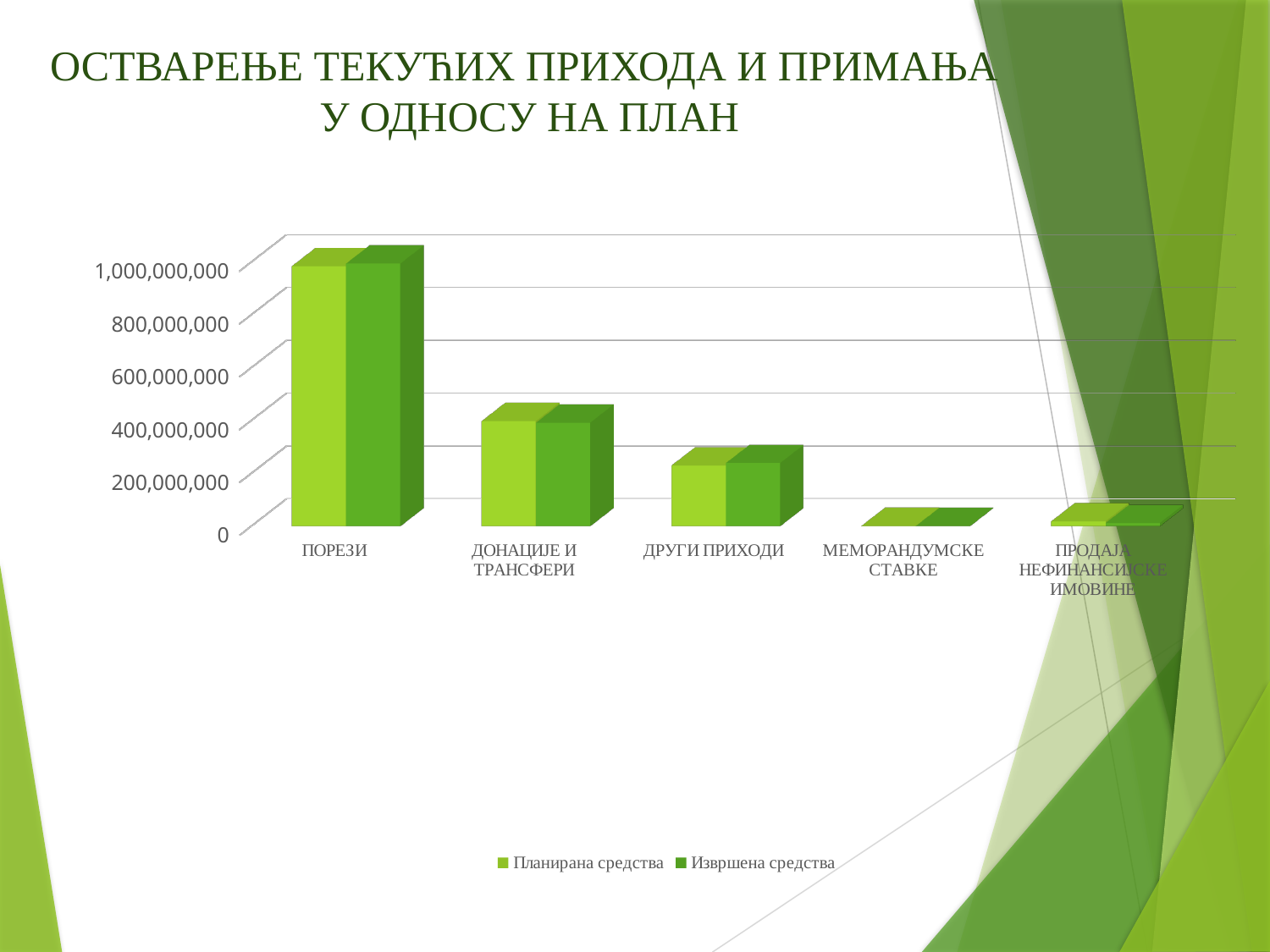
What are the two series named in the chart legend? Планирана средства and Извршена средства How many series does the chart legend list? 2 Is the value of Планирана средства for МЕМОРАНДУМСКЕ СТАВКЕ greater or less than 200,000,000? less What is the title of the slide containing the chart? ОСТВАРЕЊЕ ТЕКУЋИХ ПРИХОДА И ПРИМАЊА У ОДНОСУ НА ПЛАН Do the values in the chart generally rise or fall from left to right along the x axis? fall Is the value of Планирана средства for ДОНАЦИЈЕ И ТРАНСФЕРИ greater or less than 600,000,000? less Which category has the larger Планирана средства value: ПОРЕЗИ or ДРУГИ ПРИХОДИ? ПОРЕЗИ Which category has the highest values in the chart? ПОРЕЗИ Is the value of Извршена средства for ДРУГИ ПРИХОДИ greater or less than 400,000,000? less What kind of chart is shown on the slide? bar chart How many categories are shown on the x axis of the chart? 5